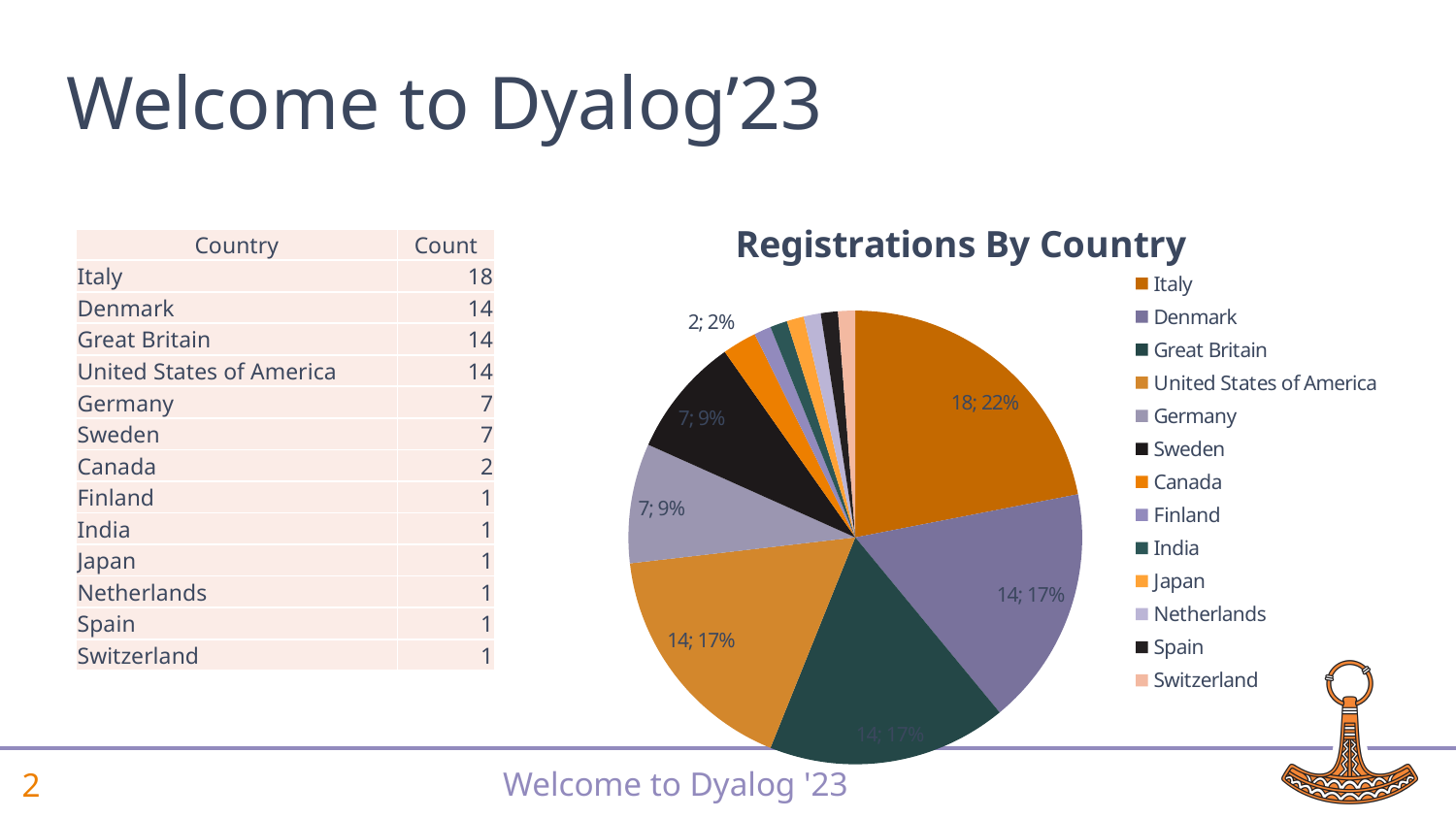
What is the title of the chart? Registrations By Country What share of the pie does Italy account for? 22% Which has more registrations, Sweden or Canada? Sweden What is the registration count shown for Germany? 7 Which country has the largest slice in the pie chart? Italy How many countries does the chart's legend list? 13 What percentage share is shown for Denmark in the pie chart? 17% What type of chart is shown on the slide? Pie chart How many slices does the pie chart have? 13 What is the registration count for Italy shown on the pie chart? 18 What is the difference between the registration counts for Italy and Germany? 11 What percentage share is shown for Canada in the pie chart? 2%